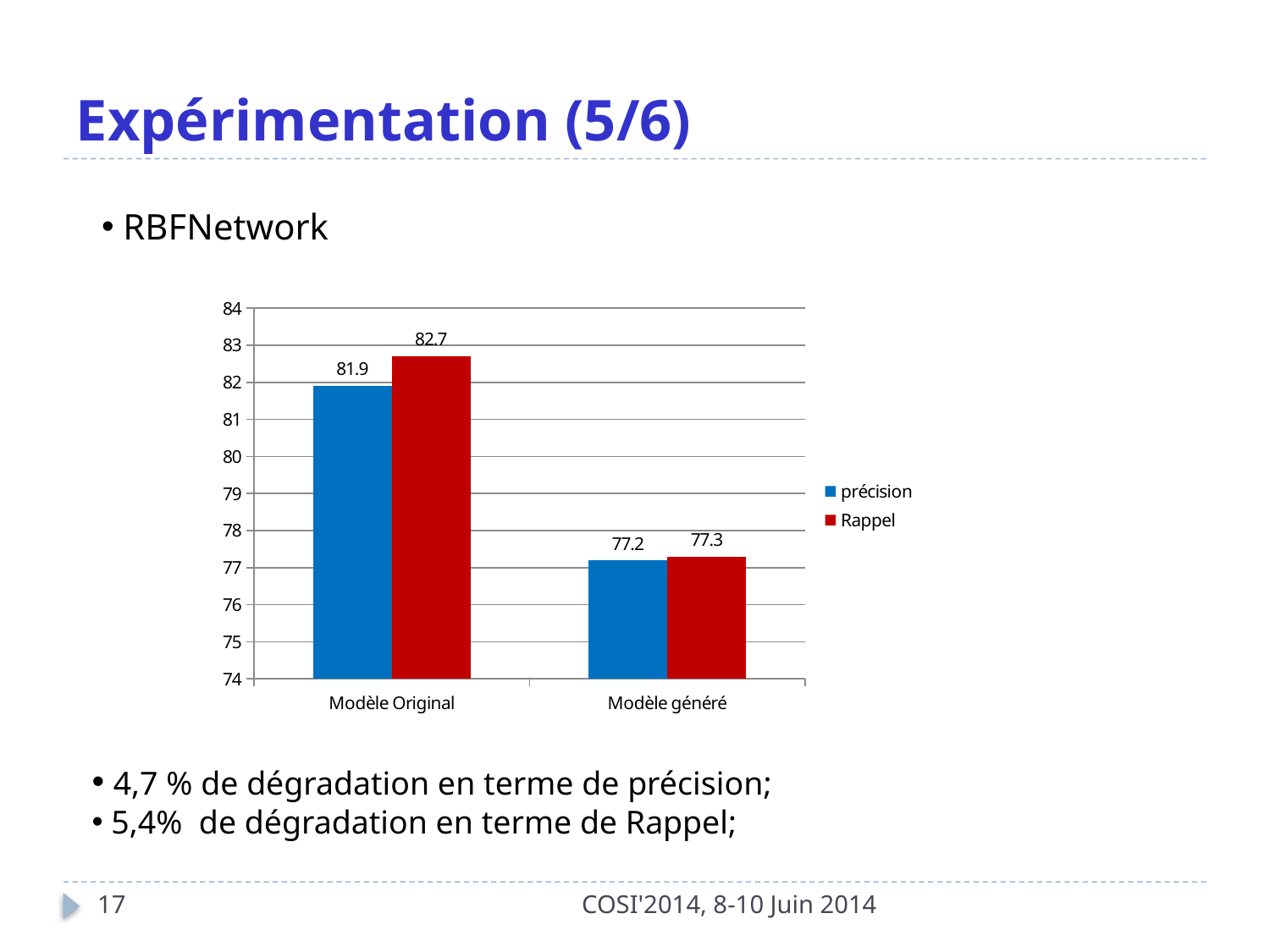
What is the Rappel value for Modèle généré? 77.3 How many categories are shown on the x axis? 2 What is the difference between the Rappel values for Modèle Original and Modèle généré? 5.4 Which is larger for Modèle Original: précision or Rappel? Rappel What kind of chart is shown on the slide? bar chart How many series does the legend list? 2 What is the Rappel value for Modèle Original? 82.7 Which category has the lowest précision value? Modèle généré What is the précision value for Modèle généré? 77.2 What is the difference between the précision values for Modèle Original and Modèle généré? 4.7 What is the précision value for Modèle Original? 81.9 Which category has the highest Rappel value? Modèle Original